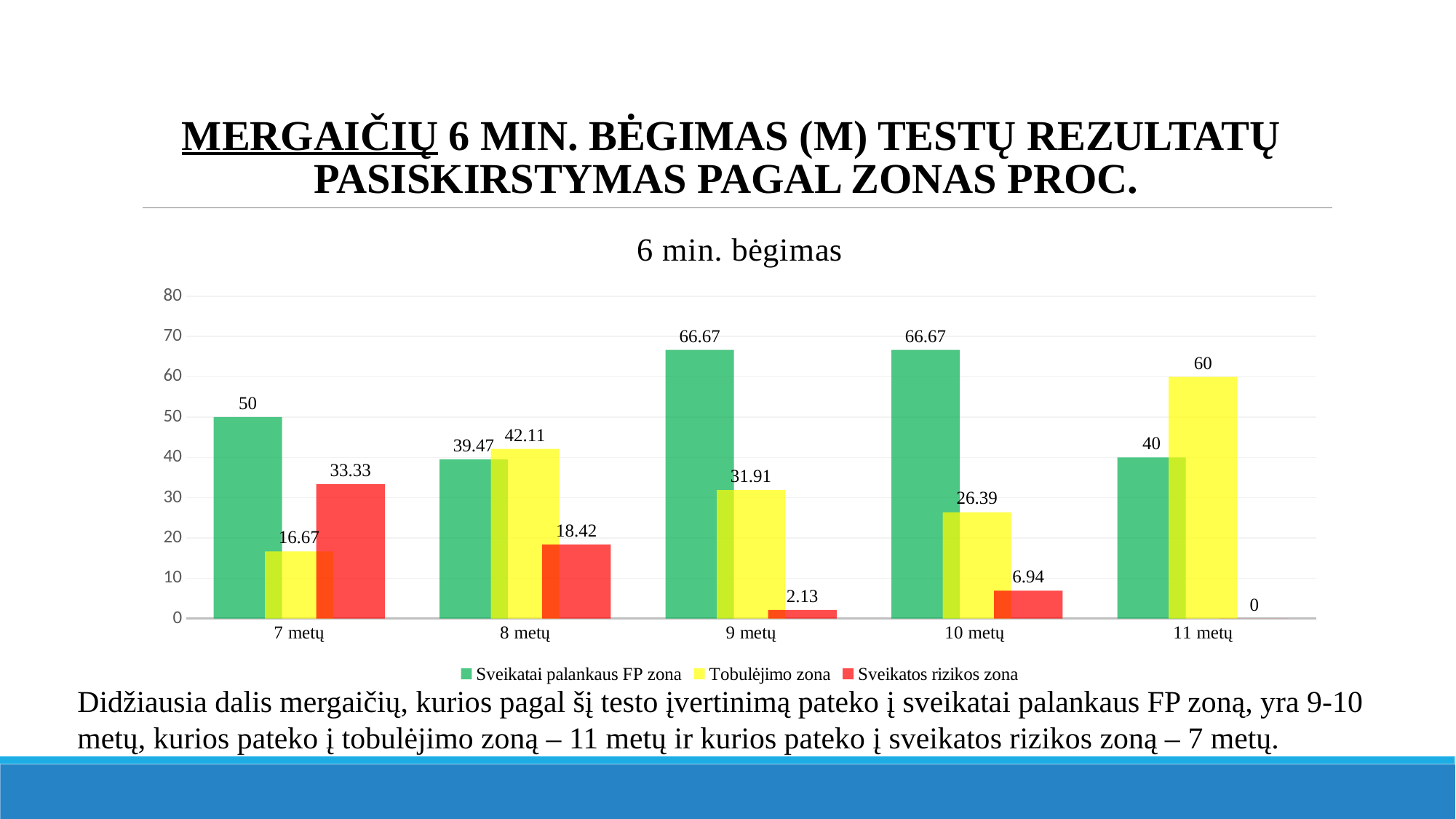
What type of chart is shown on the slide? bar chart What is the title of the chart? 6 min. bėgimas Which age category has the highest value for Tobulėjimo zona? 11 metų What is the value for Tobulėjimo zona at 8 metų? 42.11 How many age categories are shown on the x axis? 5 What is the value for Sveikatai palankaus FP zona at 7 metų? 50 Which age category has the lowest value for Sveikatos rizikos zona? 11 metų What is the difference between the Sveikatai palankaus FP zona value and the Tobulėjimo zona value at 10 metų? 40.28 What is the value for Sveikatos rizikos zona at 9 metų? 2.13 At 8 metų, which is larger: Sveikatai palankaus FP zona or Tobulėjimo zona? Tobulėjimo zona Which age category has the highest value for Sveikatos rizikos zona? 7 metų How many series does the legend list? 3